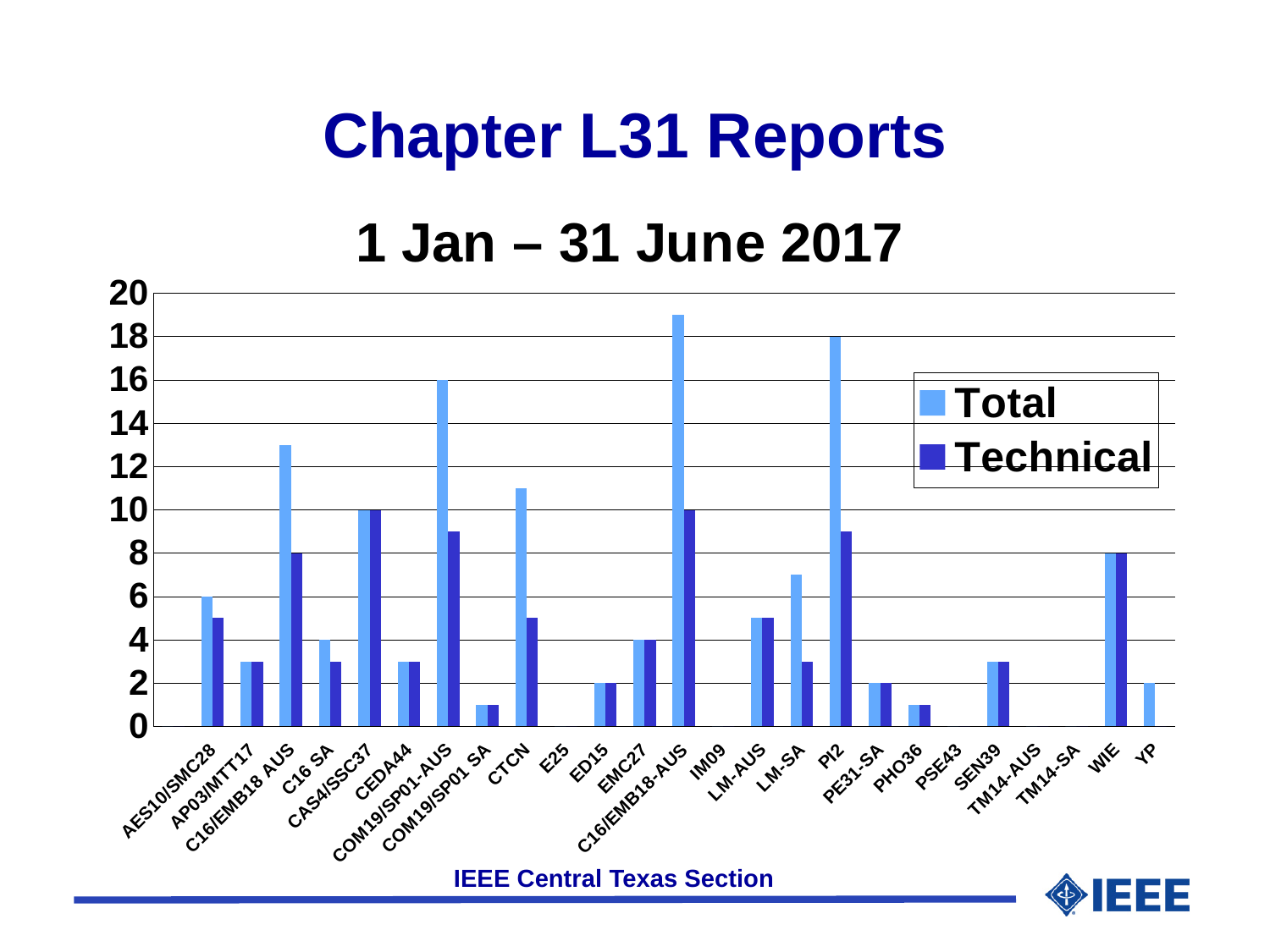
What is the Total value for COM19/SP01-AUS? 16 What is the Total value for CAS4/SSC37? 10 Which is larger, the Total value for COM19/SP01-AUS or the Total value for C16/EMB18 AUS? COM19/SP01-AUS Is the Technical value for COM19/SP01-AUS greater or less than 10? less Which chapter has the highest Total value? C16/EMB18-AUS What is the Total value for PI2? 18 How many chapters are listed on the x axis? 25 Is the Total value for CTCN greater or less than 10? greater What kind of chart is shown on the slide? bar chart How many series does the legend list? 2 What is the Technical value for WIE? 8 What is the difference between the Total values for PI2 and COM19/SP01-AUS? 2